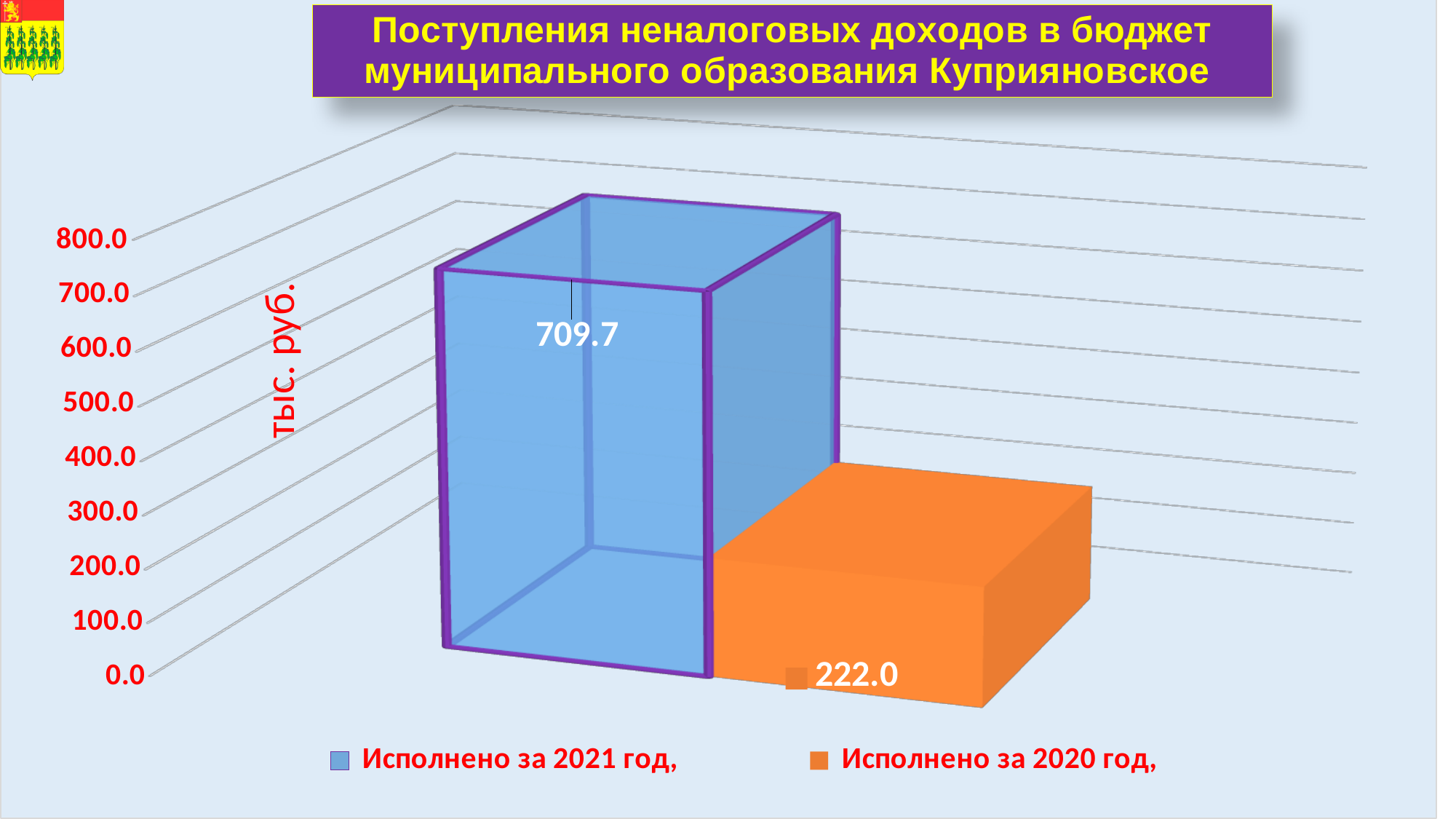
Which series has the lowest value? Исполнено за 2020 год What kind of chart is shown on the slide? Bar chart How many series does the legend list? 2 Which series has the highest value? Исполнено за 2021 год What is the difference between the 2021 value and the 2020 value? 487.7 Is the value for 'Исполнено за 2021 год' greater or less than 600.0? greater Which series has the higher value, 'Исполнено за 2021 год' or 'Исполнено за 2020 год'? Исполнено за 2021 год Is the value for 'Исполнено за 2020 год' greater or less than 300.0? less What colour is the bar for 'Исполнено за 2020 год'? Orange What is the value for 'Исполнено за 2021 год'? 709.7 What is the value for 'Исполнено за 2020 год'? 222.0 What is the unit label on the vertical axis? тыс. руб.